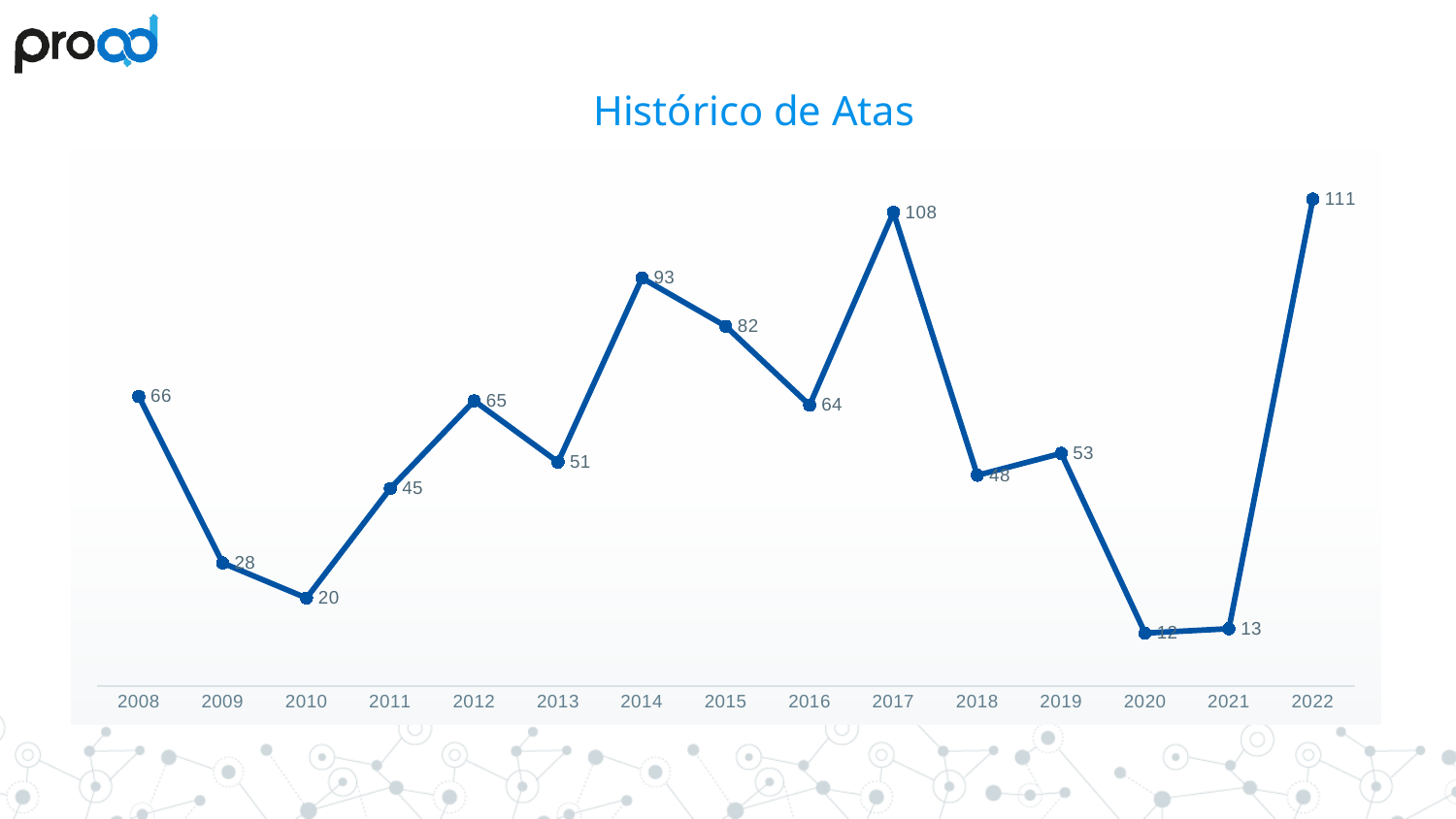
What is the value for 2010? 20 What is the value for 2014? 93 What is the value for 2017? 108 Do the values rise or fall from 2017 to 2018? fall What is the difference between the values for 2022 and 2021? 98 How many years are plotted on the x axis? 15 What type of chart is shown on the slide? line chart What is the value for 2022? 111 Which year has the highest value? 2022 Which is larger, the value for 2008 or the value for 2012? 2008 What is the title of the chart? Histórico de Atas What is the difference between the values for 2014 and 2013? 42